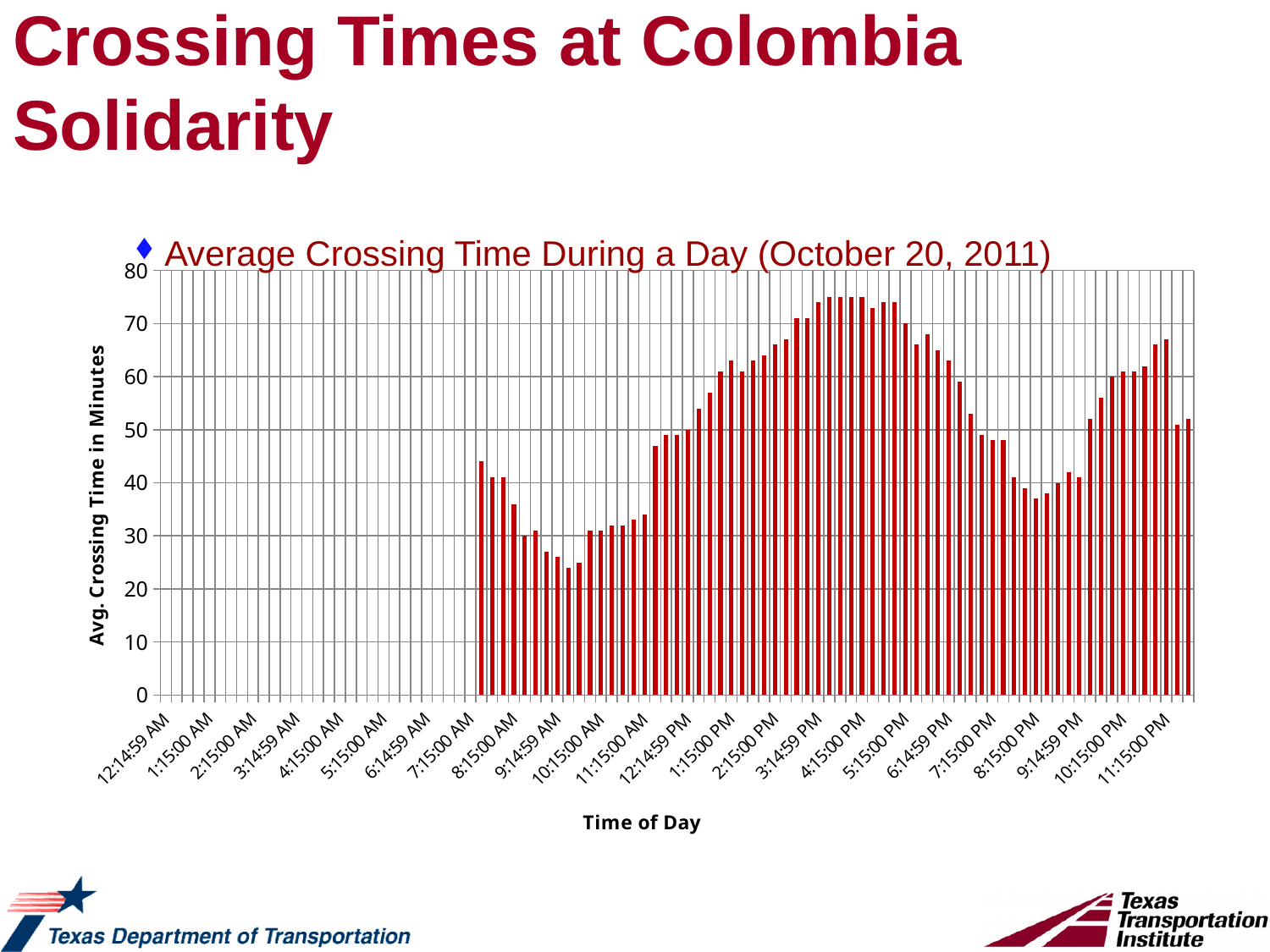
What kind of chart is shown on the slide? bar chart Is the average crossing time at 8:15:00 AM greater or less than 40 minutes? less What is the label of the vertical axis? Avg. Crossing Time in Minutes Around which labeled time of day is the average crossing time lowest? 9:14:59 AM What is the title of the chart? Average Crossing Time During a Day (October 20, 2011) Which has a higher average crossing time, 4:15:00 PM or 10:15:00 AM? 4:15:00 PM Around which labeled time of day is the average crossing time highest? 4:15:00 PM Is the average crossing time at 4:15:00 PM greater or less than 70 minutes? greater Between 10:15:00 AM and 4:15:00 PM, do the average crossing times generally rise or fall? rise Is the average crossing time at 2:15:00 PM greater or less than 60 minutes? greater